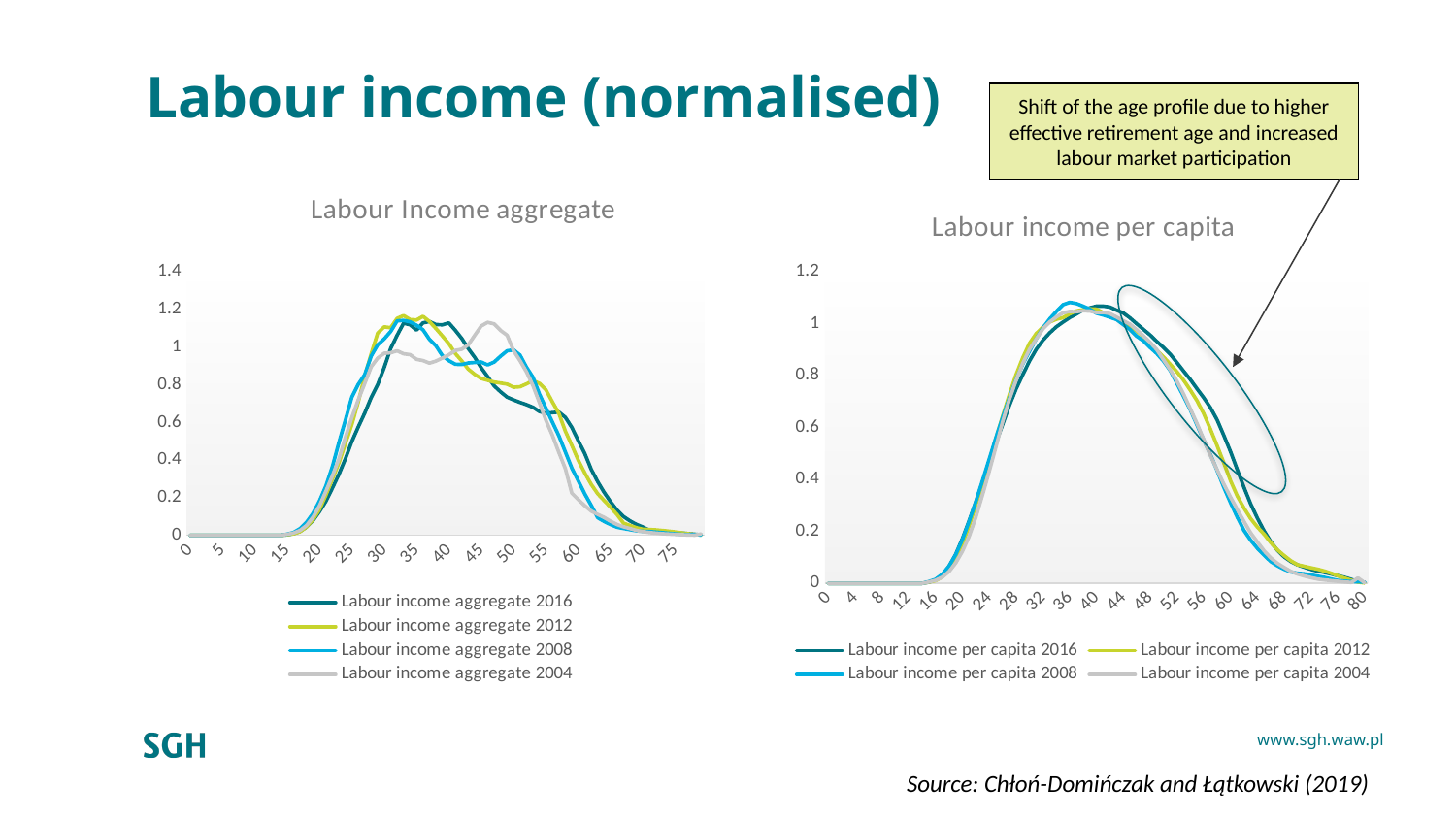
Which years are listed in the legend of the 'Labour Income aggregate' chart? 2016, 2012, 2008, 2004 In the 'Labour income per capita' chart, is the value for Labour income per capita 2016 at age 40 greater or less than 0.8? greater In the 'Labour income per capita' chart, is the value for Labour income per capita 2008 at age 64 greater or less than 0.4? less What is the title of the chart on the right side of the slide? Labour income per capita In the 'Labour Income aggregate' chart, does the Labour income aggregate 2016 line rise or fall between age 40 and age 60? fall In the 'Labour Income aggregate' chart, is the value for Labour income aggregate 2004 at age 45 greater or less than 1? greater How many series does the legend of the 'Labour Income aggregate' chart list? 4 In the 'Labour income per capita' chart, does the Labour income per capita 2012 line rise or fall between age 20 and age 36? rise What kind of chart is the 'Labour income per capita' chart on the right? Line chart How many series does the legend of the 'Labour income per capita' chart list? 4 What kind of chart is the 'Labour Income aggregate' chart on the left? Line chart